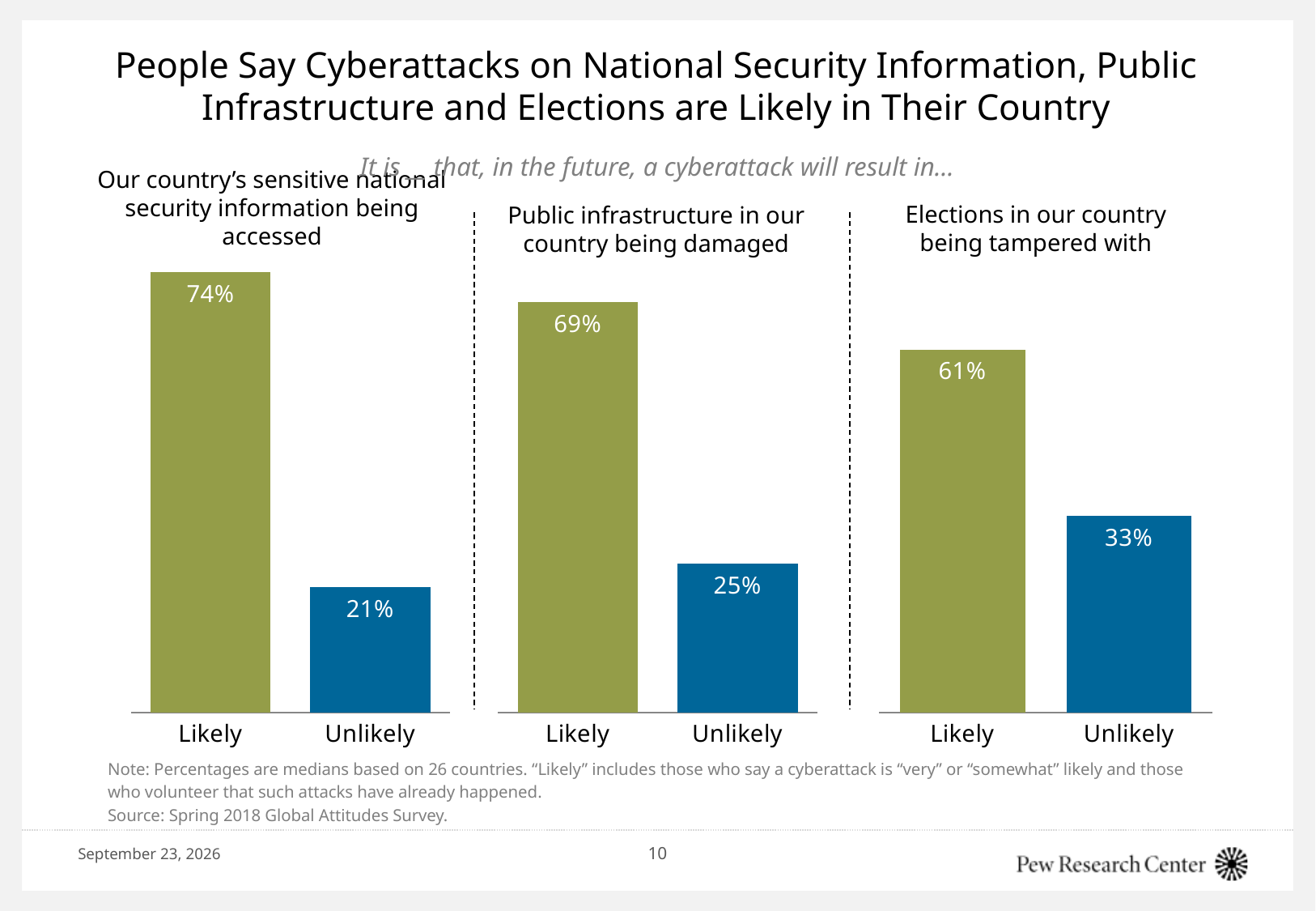
In the chart titled "Our country's sensitive national security information being accessed", what is the value for Unlikely? 21% In the chart titled "Our country's sensitive national security information being accessed", what is the difference between the Likely and Unlikely values? 53 percentage points What kind of chart is the chart titled "Elections in our country being tampered with"? Bar chart In the chart titled "Public infrastructure in our country being damaged", what is the value for Likely? 69% In the chart titled "Public infrastructure in our country being damaged", what is the value for Unlikely? 25% How many bars are shown in the chart titled "Public infrastructure in our country being damaged"? 2 In the chart titled "Public infrastructure in our country being damaged", which category has the higher value, Likely or Unlikely? Likely In the chart titled "Elections in our country being tampered with", what is the value for Unlikely? 33% In the chart titled "Elections in our country being tampered with", what is the value for Likely? 61% In the chart titled "Our country's sensitive national security information being accessed", what colour is the Likely bar? Green In the chart titled "Our country's sensitive national security information being accessed", what is the value for Likely? 74% In the chart titled "Elections in our country being tampered with", what is the difference between the Likely and Unlikely values? 28 percentage points